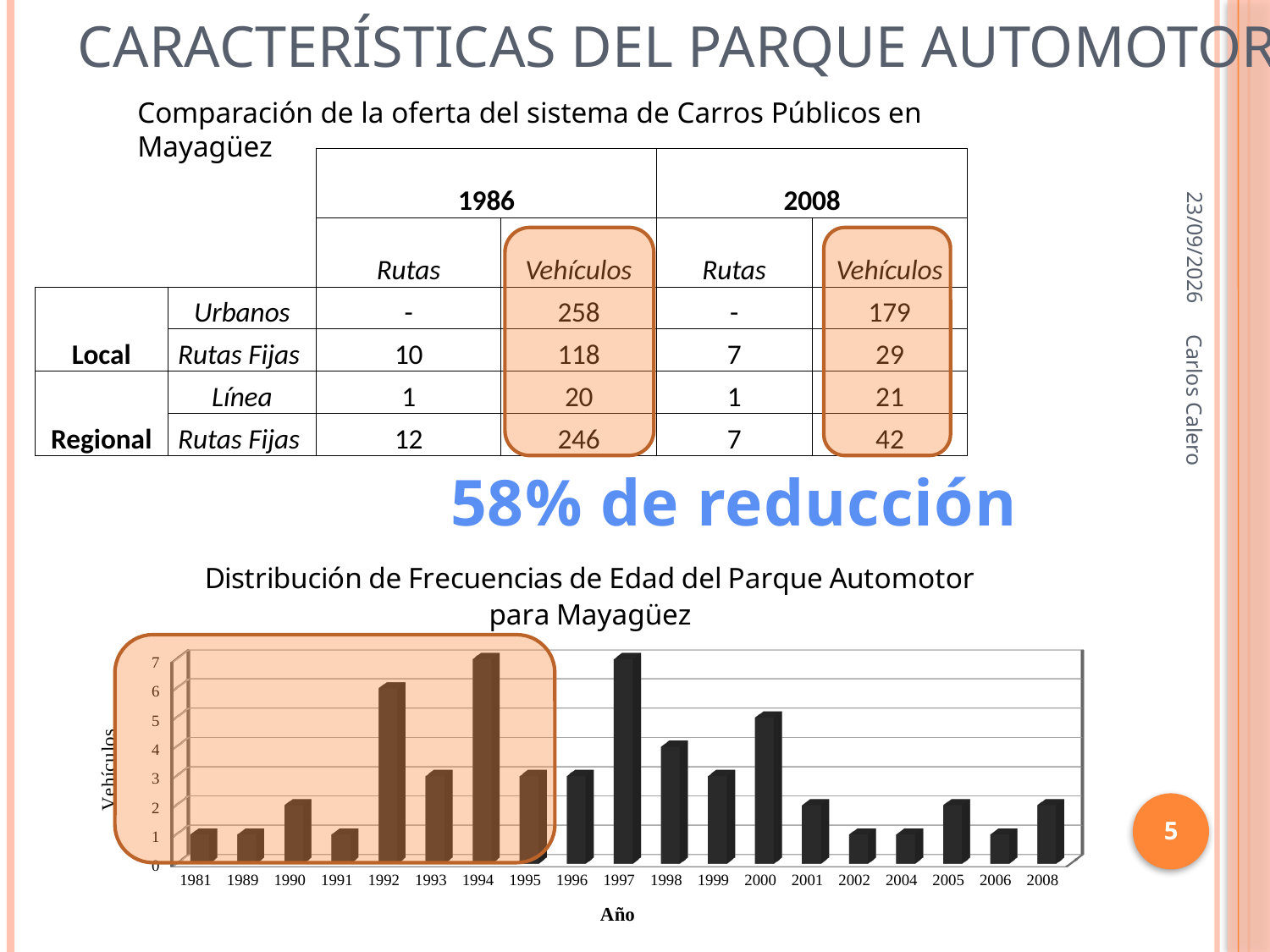
In the 'Distribución de Frecuencias de Edad' chart, is the value for 1998 greater or less than 3? greater In the 'Distribución de Frecuencias de Edad' chart, which year has the larger value, 1992 or 1993? 1992 In the 'Distribución de Frecuencias de Edad' chart, which year has the larger value, 2000 or 2001? 2000 In the 'Distribución de Frecuencias de Edad' chart, what is the value for 2000? 5 How many years are shown on the x axis of the 'Distribución de Frecuencias de Edad' chart? 19 What is the x-axis title of the 'Distribución de Frecuencias de Edad' chart? Año In the 'Distribución de Frecuencias de Edad' chart, is the value for 2002 greater or less than 2? less What is the y-axis label of the 'Distribución de Frecuencias de Edad' chart? Vehículos In the 'Distribución de Frecuencias de Edad' chart, what is the value for 1994? 7 In the 'Distribución de Frecuencias de Edad' chart, is the value for 1992 greater or less than 5? greater What kind of chart is shown at the bottom of the slide? bar chart In the 'Distribución de Frecuencias de Edad' chart, which year has the larger value, 1997 or 1998? 1997